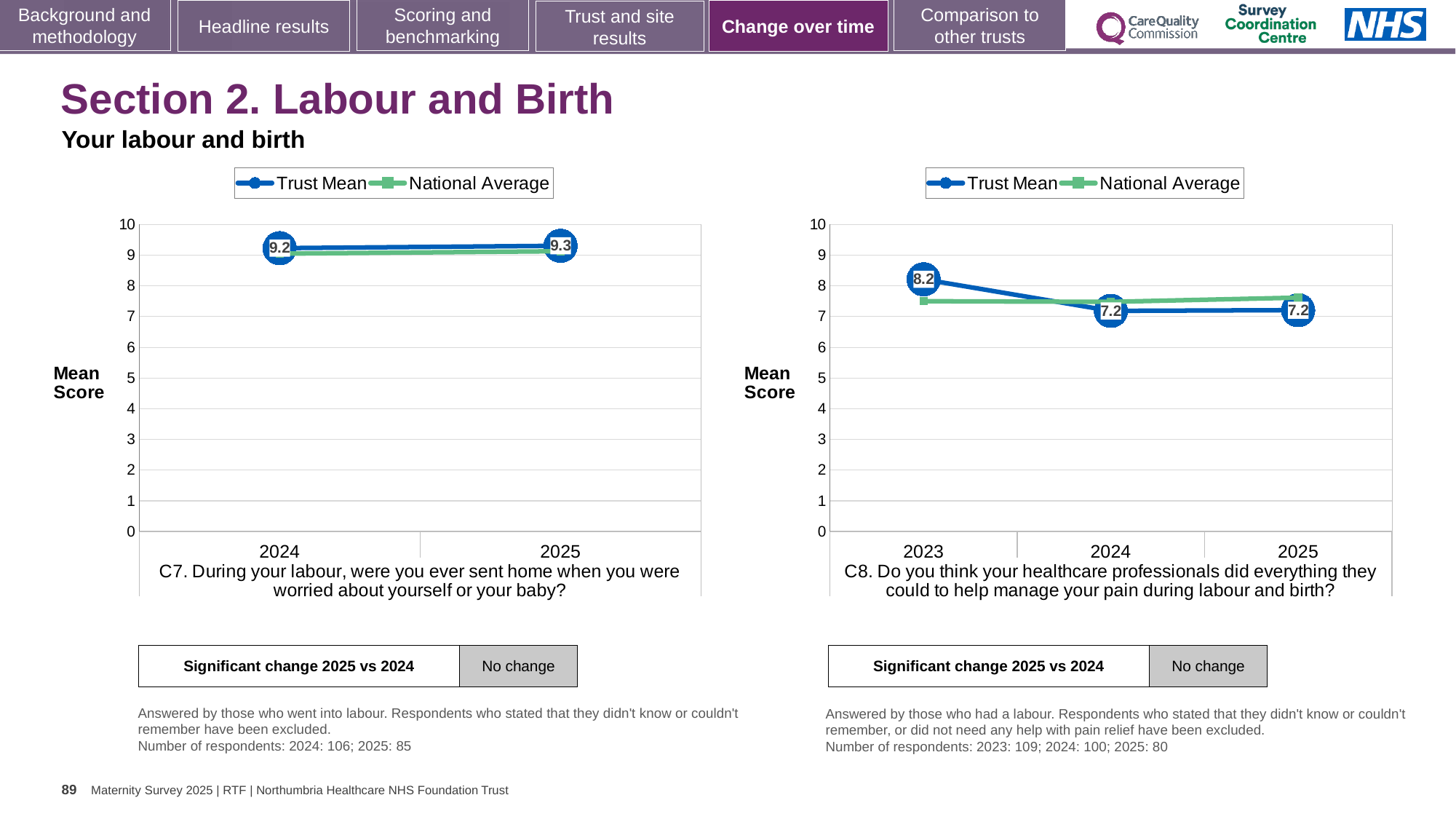
In the right chart (C8), by how much did the Trust Mean fall from 2023 to 2024? 1.0 In the left chart (C7), what is the Trust Mean for 2024? 9.2 In the right chart (C8), which year has the highest Trust Mean? 2023 In the right chart (C8), does the Trust Mean rise or fall from 2023 to 2025? fall In the right chart (C8), is the National Average for 2025 greater or less than 7? greater In the left chart (C7), is the National Average for 2024 greater or less than 8? greater In the right chart (C8), what is the Trust Mean for 2023? 8.2 How many series does the legend of the left chart (C7) list? 2 How many years are plotted on the x axis of the right chart (C8)? 3 In the left chart (C7), what is the Trust Mean for 2025? 9.3 What kind of chart is the left chart (C7)? line chart In the right chart (C8), what is the Trust Mean for 2025? 7.2